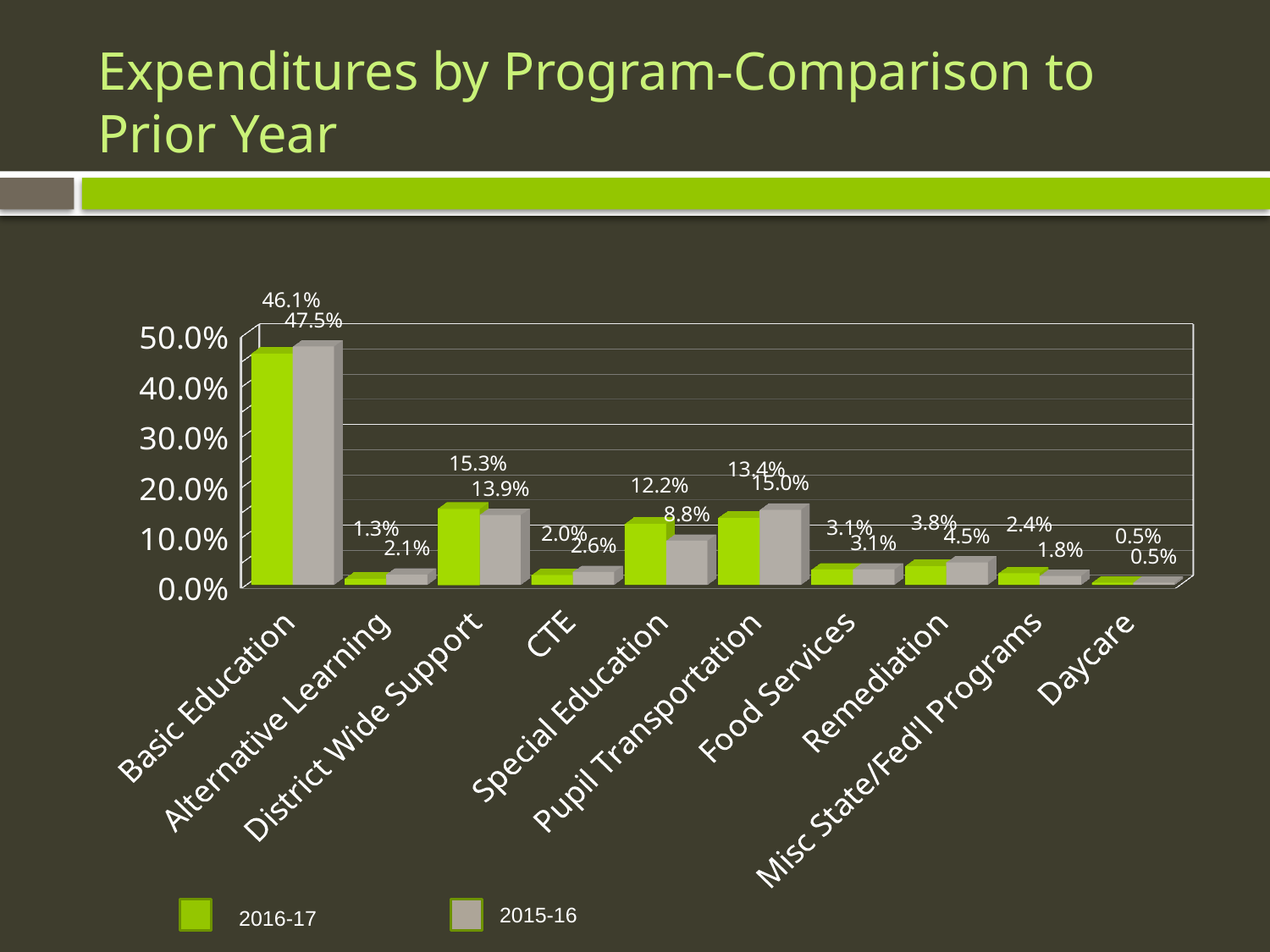
Which program has the highest 2016-17 value? Basic Education What kind of chart is shown on the slide? Bar chart What is the 2015-16 value for Remediation? 4.5% What is the 2016-17 value for Basic Education? 46.1% Which is larger for District Wide Support, the 2016-17 value or the 2015-16 value? 2016-17 What is the 2016-17 value for Special Education? 12.2% What is the difference between the 2016-17 and 2015-16 values for Special Education? 3.4% What is the difference between the 2015-16 and 2016-17 values for Basic Education? 1.4% What is the 2015-16 value for Pupil Transportation? 15.0% How many series does the legend list? 2 How many programs are shown on the x axis? 10 Which program has the lowest 2015-16 value? Daycare